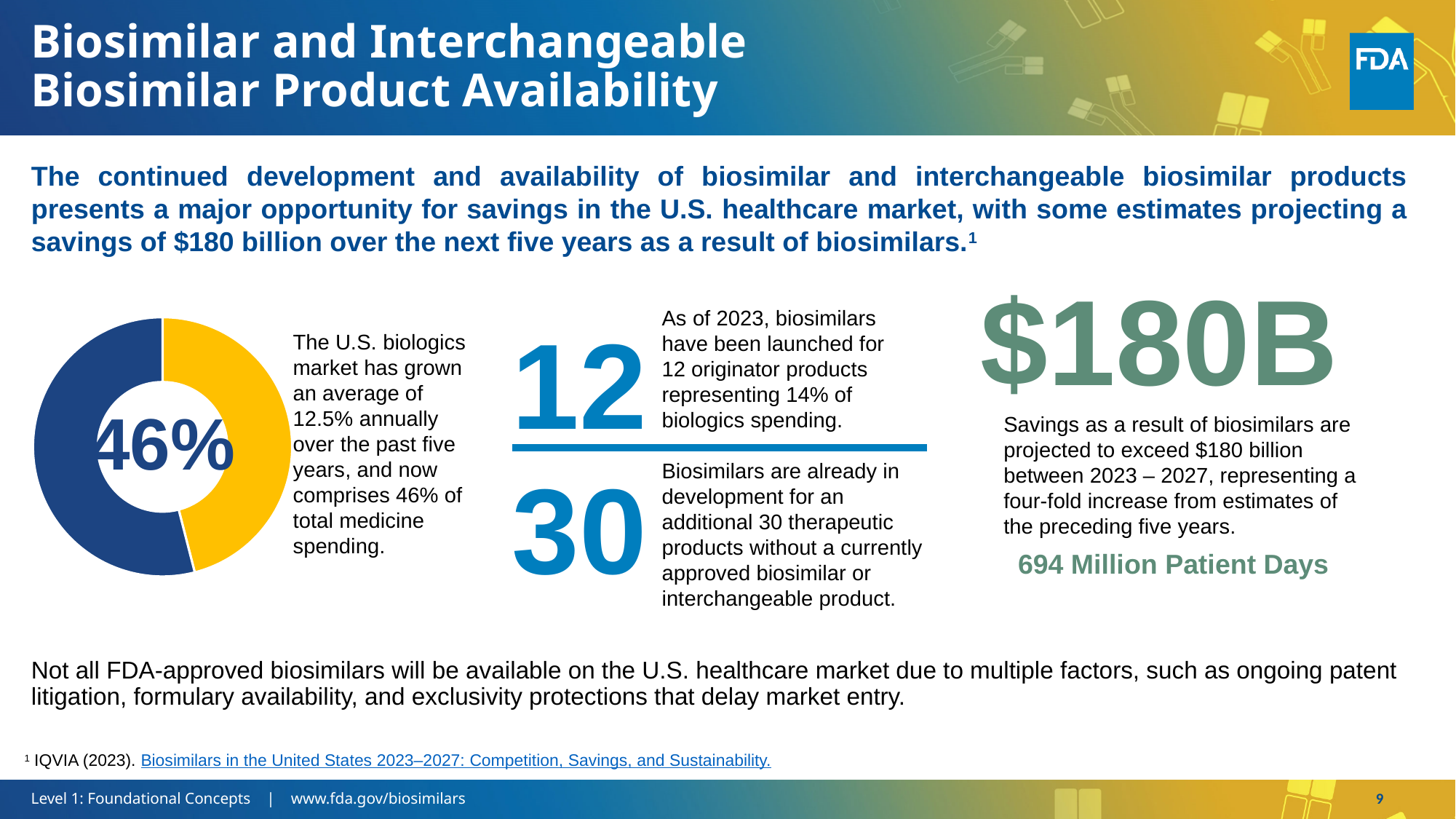
According to the text beside the donut chart, what does the 46% represent? biologics' share of total medicine spending Is the value shown in the donut chart greater or less than 50%? less Which slice of the donut chart is larger, the blue one or the yellow one? blue What kind of chart is shown on the left of the slide? pie chart (donut) How many slices does the donut chart have? 2 What percentage is printed in the centre of the donut chart? 46% What two colours are used for the slices of the donut chart? blue and yellow